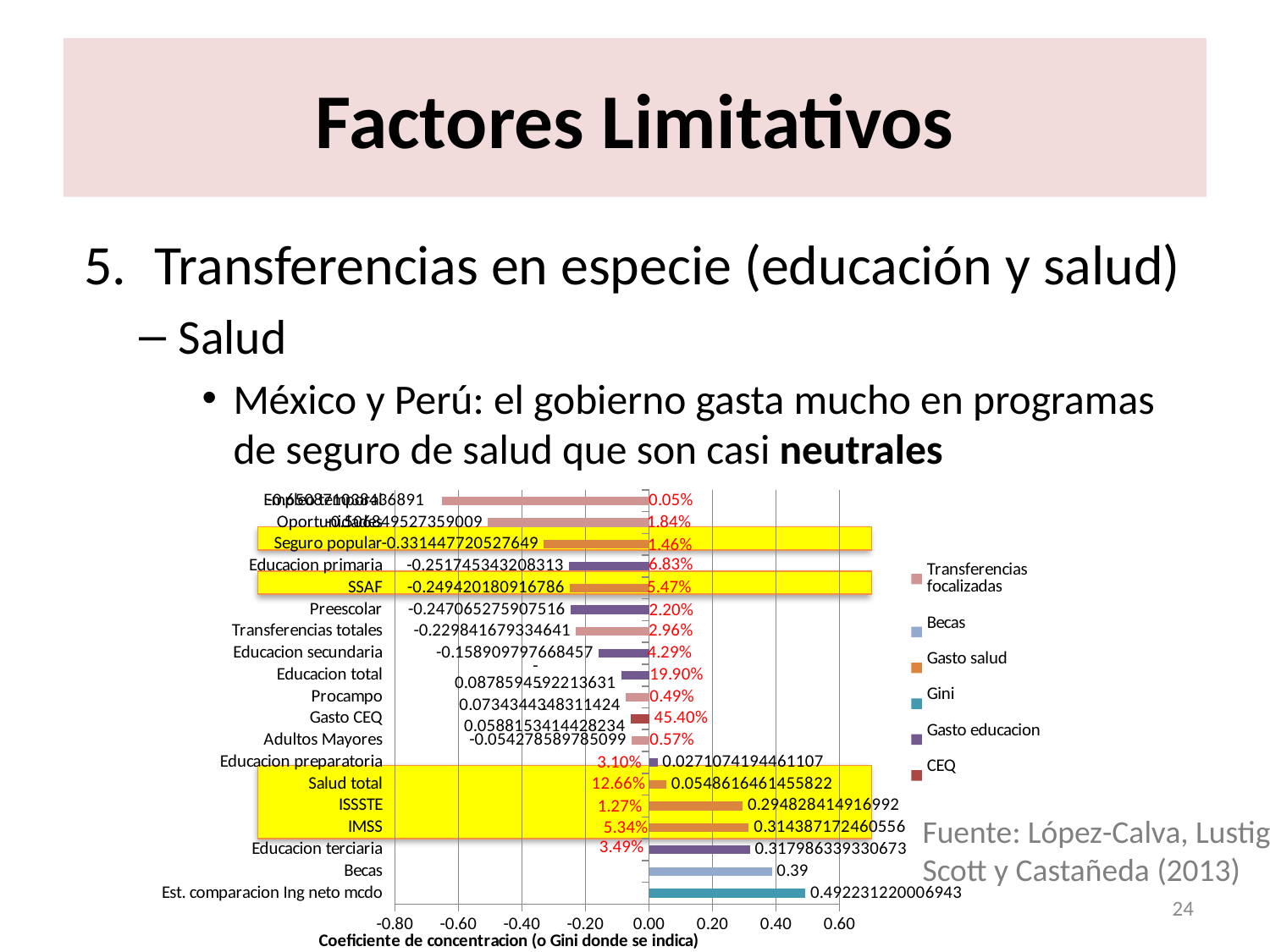
Which category has the lowest (most negative) value in the chart? Empleo temporal What is the value for Seguro popular in the chart? -0.331447720527649 What is the value for Becas in the chart? 0.39 What is the value for Est. comparacion Ing neto mcdo in the chart? 0.492231220006943 Which has a larger value, IMSS or ISSSTE? IMSS What type of chart is shown on the slide? bar chart What is the value for IMSS in the chart? 0.314387172460556 How many categories are plotted on the vertical axis of the chart? 19 Which category has the highest value in the chart? Est. comparacion Ing neto mcdo Is the value for Educacion terciaria greater or less than 0.20? greater How many series does the chart legend list? 6 What is the x-axis title of the chart? Coeficiente de concentracion (o Gini donde se indica)